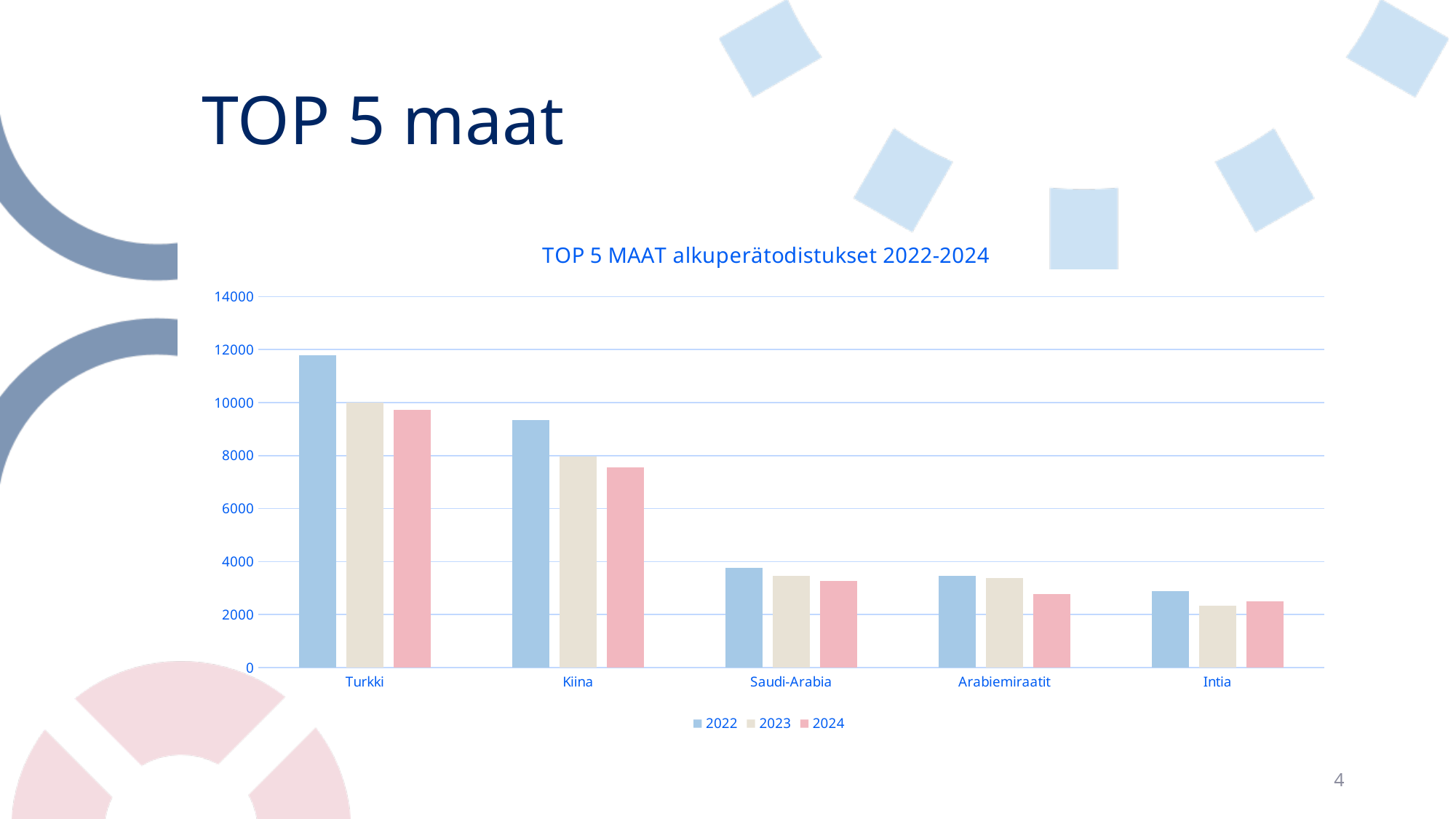
Do the values for Turkki rise or fall from 2022 to 2024? fall Which is larger, the 2024 value for Saudi-Arabia or the 2024 value for Arabiemiraatit? Saudi-Arabia Is the 2022 value for Turkki greater or less than 12000? less Is the 2022 value for Saudi-Arabia greater or less than 4000? less How many series does the legend list? 3 How many countries are shown on the x axis? 5 Which country has the highest 2022 value? Turkki What kind of chart is shown on the slide? bar chart What is the title of the chart? TOP 5 MAAT alkuperätodistukset 2022-2024 Is the 2022 value for Kiina greater or less than 8000? greater Which country has the lowest 2023 value? Intia